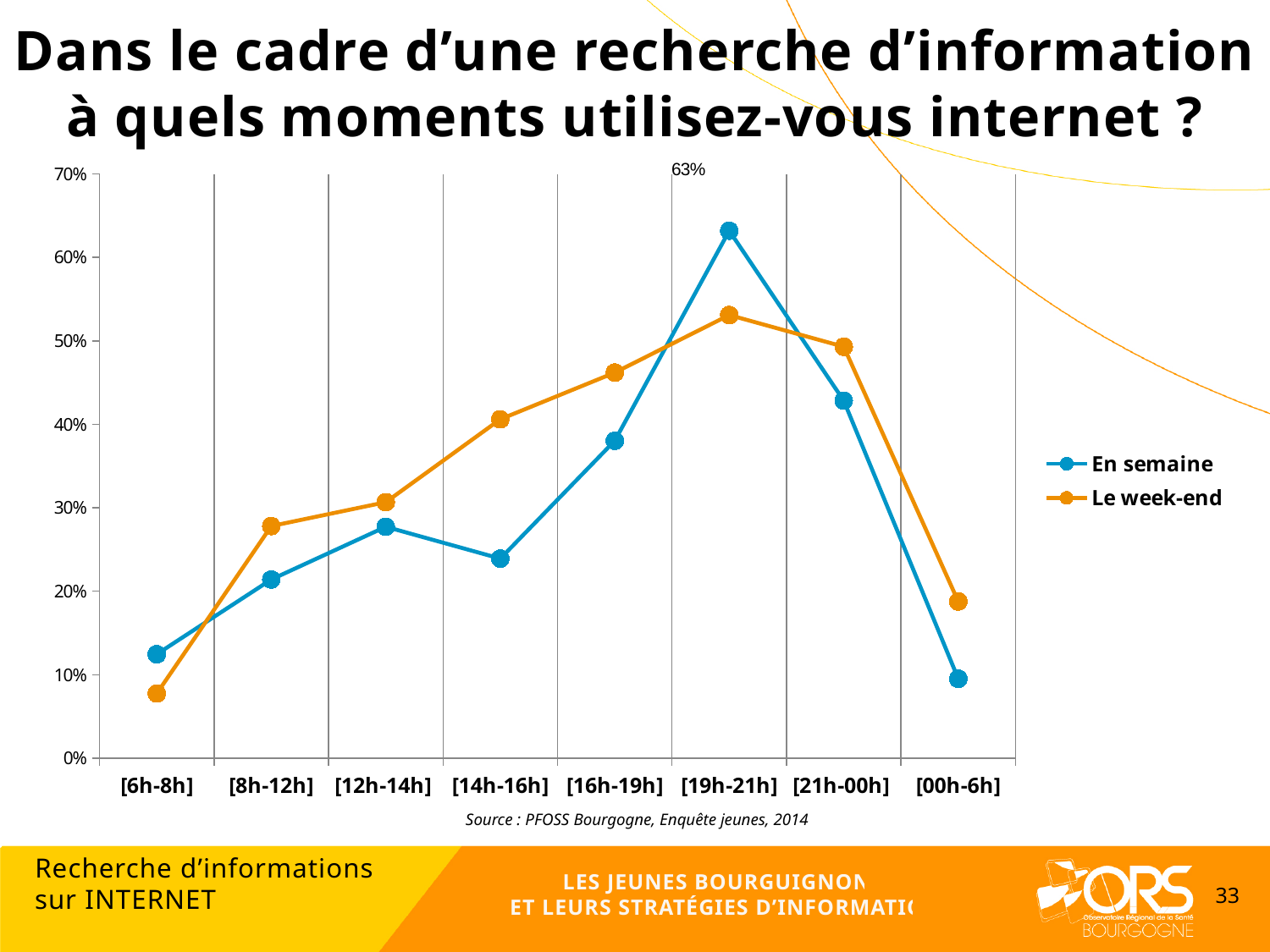
For which time slot is the Le week-end value highest? [19h-21h] For which time slot is the En semaine value lowest? [00h-6h] For which time slot is the En semaine value highest? [19h-21h] What kind of chart is shown on the slide? Line chart What is the value for En semaine at [19h-21h]? 63% How many series does the legend list? 2 At [16h-19h], which series has the larger value, En semaine or Le week-end? Le week-end Is the value for Le week-end at [00h-6h] greater or less than 20%? less At [19h-21h], which series has the larger value, En semaine or Le week-end? En semaine For which time slot is the Le week-end value lowest? [6h-8h] Is the value for En semaine at [16h-19h] greater or less than 40%? less How many time slots are shown on the x axis? 8